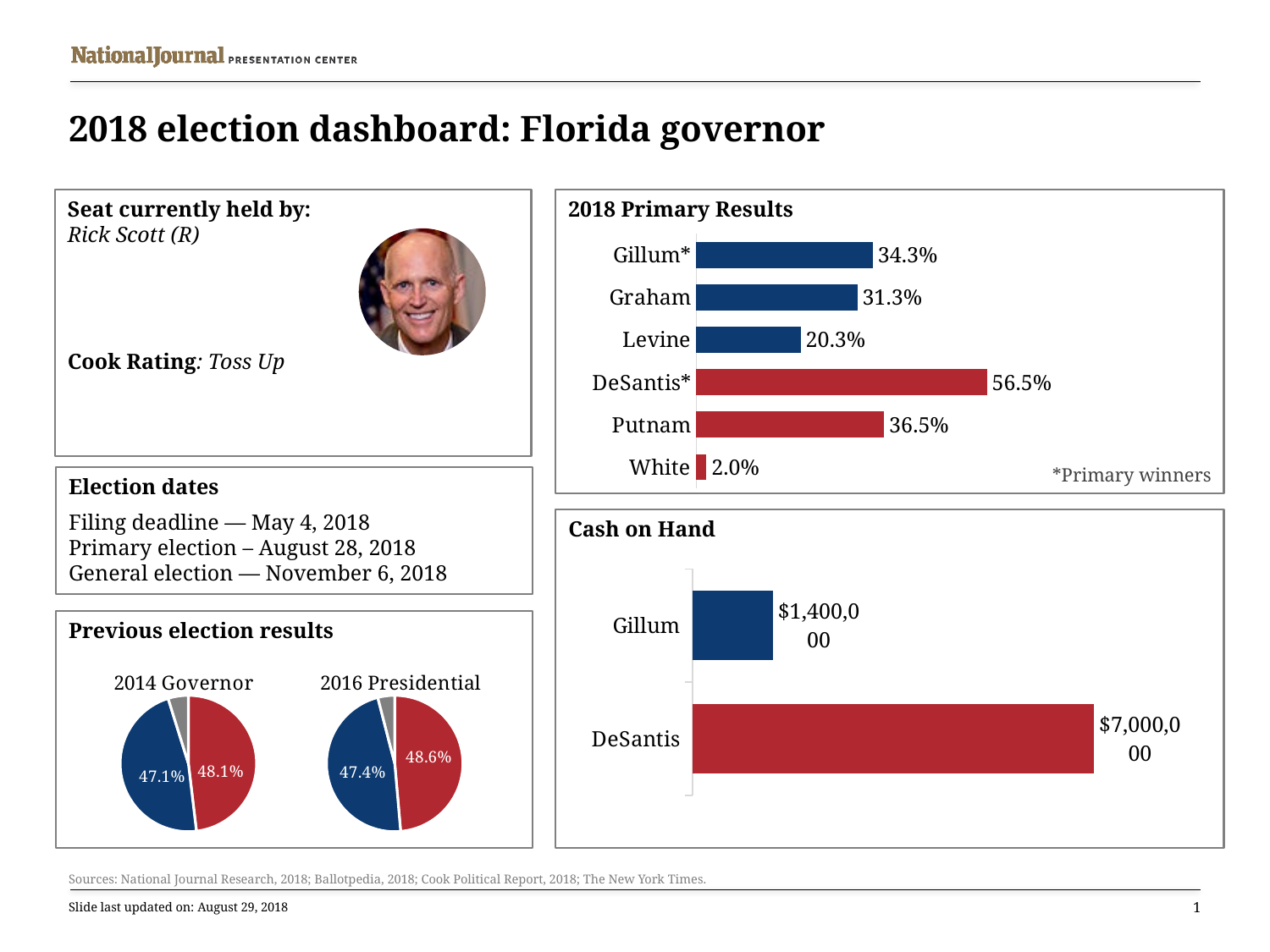
In the 2018 Primary Results chart, who received a higher percentage, Graham or Levine? Graham What type of chart is the 2018 Primary Results chart? Bar chart In the 2018 Primary Results chart, what percentage did Gillum receive? 34.3% In the 2018 Primary Results chart, which candidate has the lowest percentage? White In the 2018 Primary Results chart, which candidate has the highest percentage? DeSantis How many candidates are shown in the 2018 Primary Results chart? 6 In the 2016 Presidential pie chart under Previous election results, what share is shown for the blue slice? 47.4% In the Cash on Hand chart, what is the difference between DeSantis's and Gillum's cash on hand? $5,600,000 In the Cash on Hand chart, how much cash on hand does DeSantis have? $7,000,000 In the 2018 Primary Results chart, what percentage did Putnam receive? 36.5% In the 2014 Governor pie chart under Previous election results, what is the larger labelled share? 48.1% In the 2018 Primary Results chart, what is the difference between DeSantis's and Putnam's percentages? 20.0 percentage points